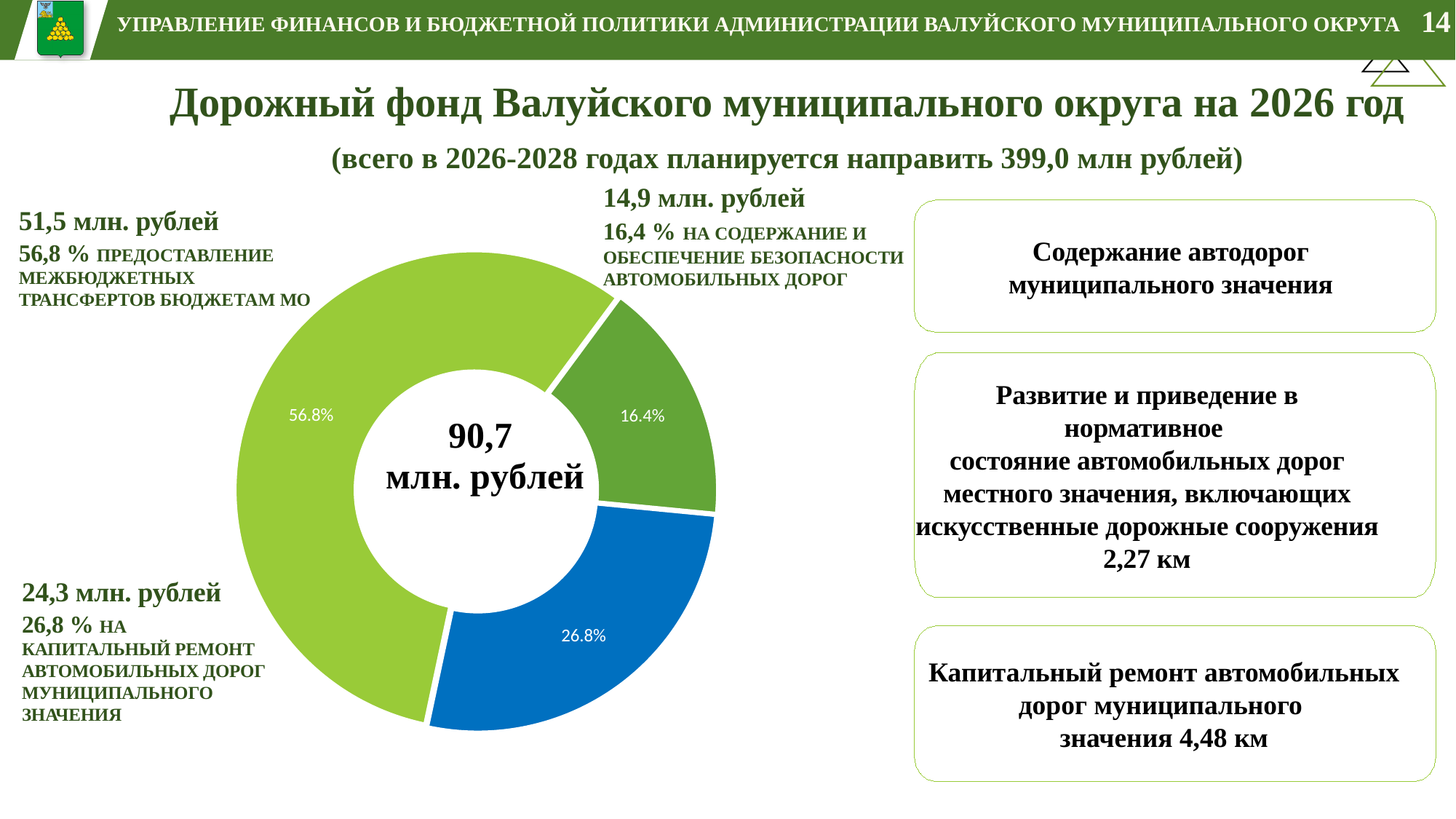
Which slice of the doughnut chart is the largest? Предоставление межбюджетных трансфертов бюджетам МО (56.8%) What share of the doughnut chart is labelled for капитальный ремонт автомобильных дорог муниципального значения? 26.8% How many slices does the doughnut chart have? 3 What amount in млн. рублей is shown for капитальный ремонт автомобильных дорог муниципального значения? 24,3 млн. рублей What share of the doughnut chart is labelled for содержание и обеспечение безопасности автомобильных дорог? 16.4% What is the difference in млн. рублей between the amount for межбюджетные трансферты and the amount for капитальный ремонт? 27,2 млн. рублей What kind of chart is shown on the slide? Doughnut (pie) chart What total value is printed in the centre of the doughnut chart? 90,7 млн. рублей What amount in млн. рублей is shown for предоставление межбюджетных трансфертов бюджетам МО? 51,5 млн. рублей What amount in млн. рублей is shown for содержание и обеспечение безопасности автомобильных дорог? 14,9 млн. рублей What share of the doughnut chart is labelled for предоставление межбюджетных трансфертов бюджетам МО? 56.8% Which slice of the doughnut chart is the smallest? Содержание и обеспечение безопасности автомобильных дорог (16.4%)